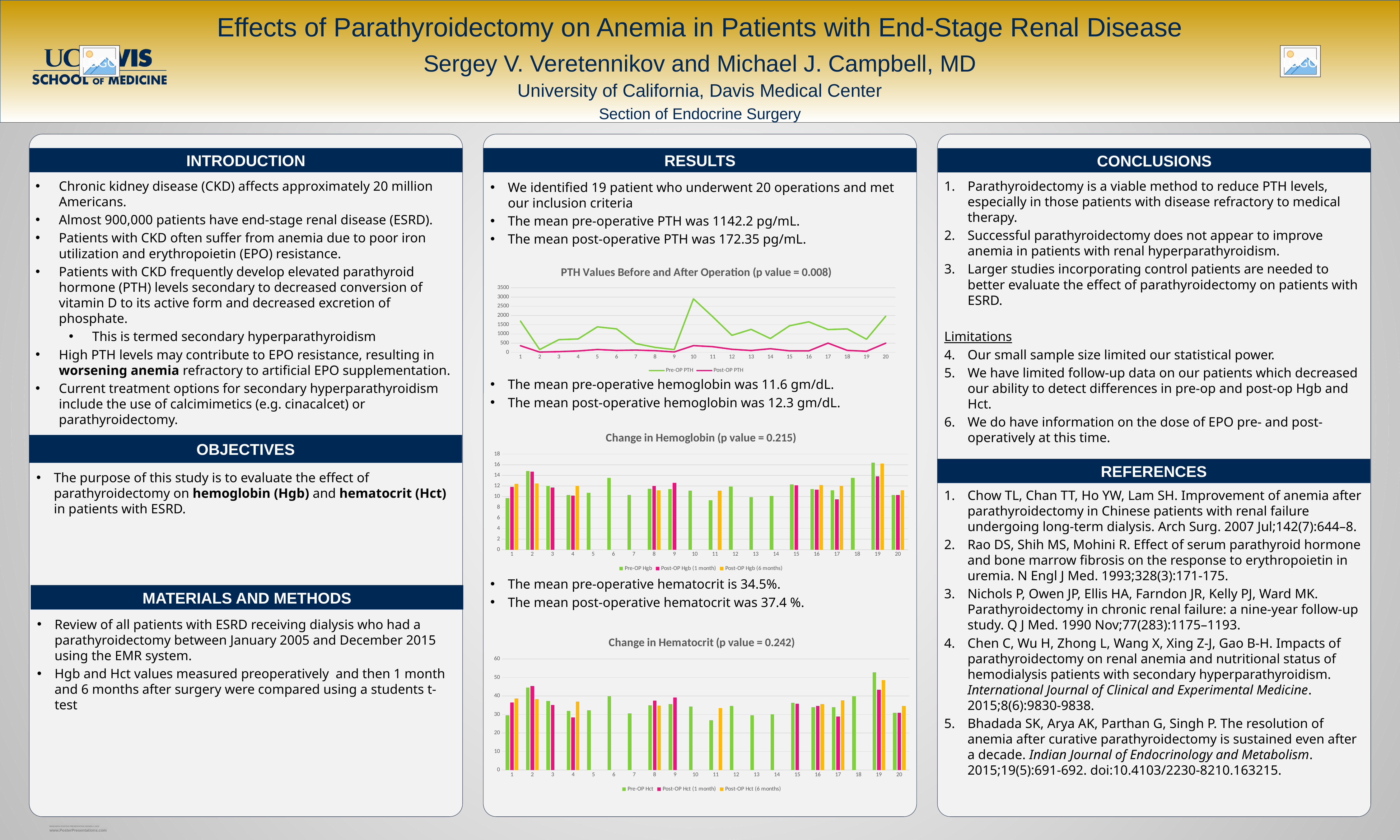
In the 'PTH Values Before and After Operation' chart, is the Pre-OP PTH value for patient 10 greater or less than 2500? greater What p value is shown in the title of the 'Change in Hemoglobin' chart? 0.215 In the 'Change in Hemoglobin' chart, is the Pre-OP Hgb value for patient 19 greater or less than 14? greater In the 'PTH Values Before and After Operation' chart, which patient number has the highest Pre-OP PTH value? 10 In the 'Change in Hemoglobin' chart, which patient number has the highest Pre-OP Hgb value? 19 In the 'Change in Hematocrit' chart, is the Pre-OP Hct value for patient 19 greater or less than 40? greater How many series does the legend of the 'Change in Hematocrit' chart list? 3 How many series does the legend of the 'PTH Values Before and After Operation' chart list? 2 How many patient categories are shown on the x axis of the 'Change in Hemoglobin' chart? 20 What kind of chart is the 'Change in Hemoglobin' chart? bar chart What kind of chart is the 'PTH Values Before and After Operation' chart? line chart